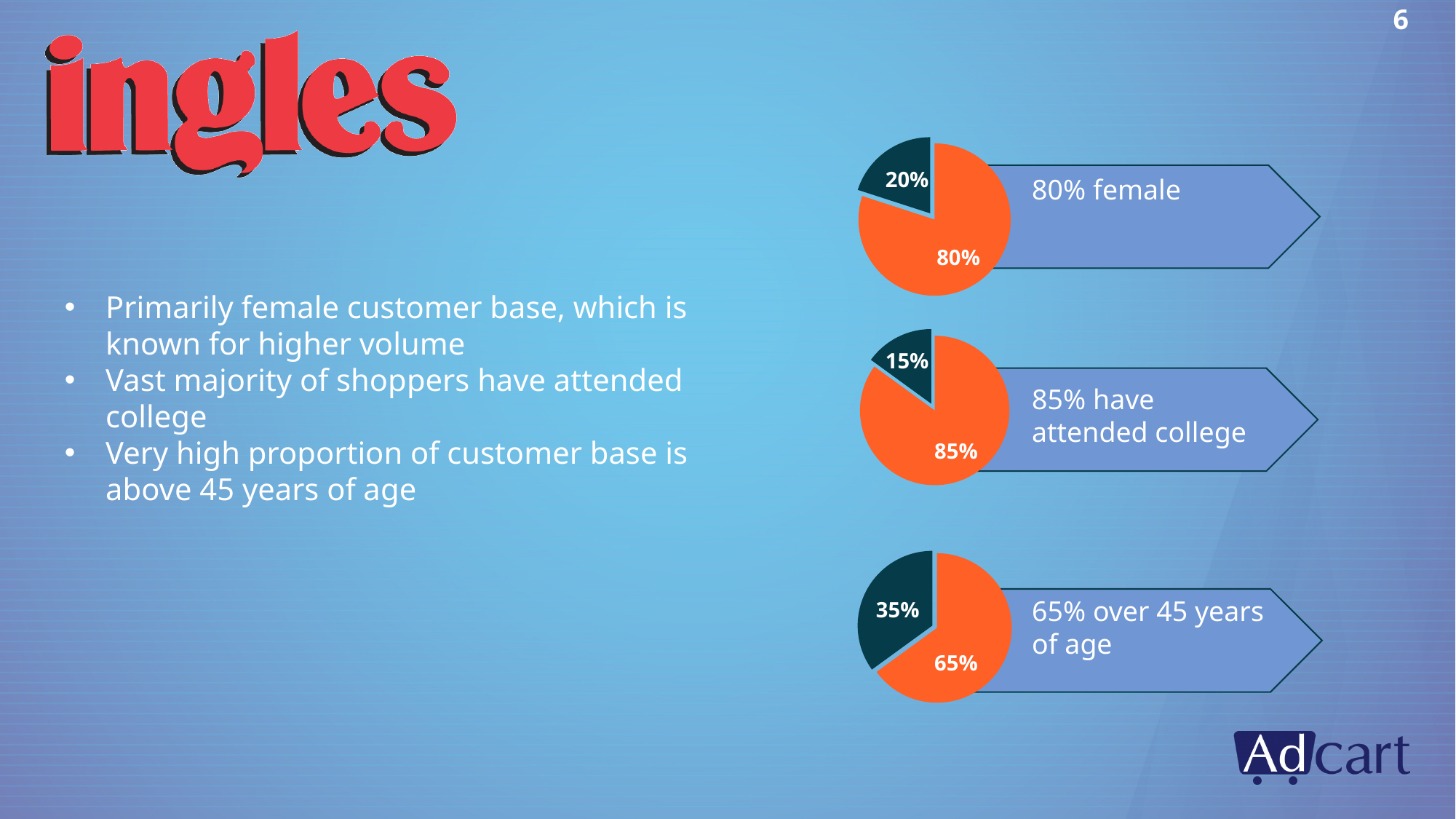
How many pie charts are on the slide? 3 In the middle pie chart (85% have attended college), what value is shown on the smaller slice? 15% What kind of chart is used for each of the three charts on the slide? Pie chart How many slices does each pie chart have? 2 In the top pie chart (80% female), what value is shown on the dark teal slice? 20% Which of the three pie charts has the largest dark teal slice? The bottom one (65% over 45 years of age) In the bottom pie chart (65% over 45 years of age), what is the difference between the two slices? 30% In the bottom pie chart (65% over 45 years of age), what value is shown on the dark teal slice? 35% In the top pie chart (80% female), what value is shown on the orange slice? 80% In the middle pie chart (85% have attended college), what is the difference between the larger and smaller slices? 70% In the top pie chart (80% female), which slice is larger, the orange one or the dark teal one? The orange one Which of the three pie charts has the smallest dark teal slice? The middle one (85% have attended college)